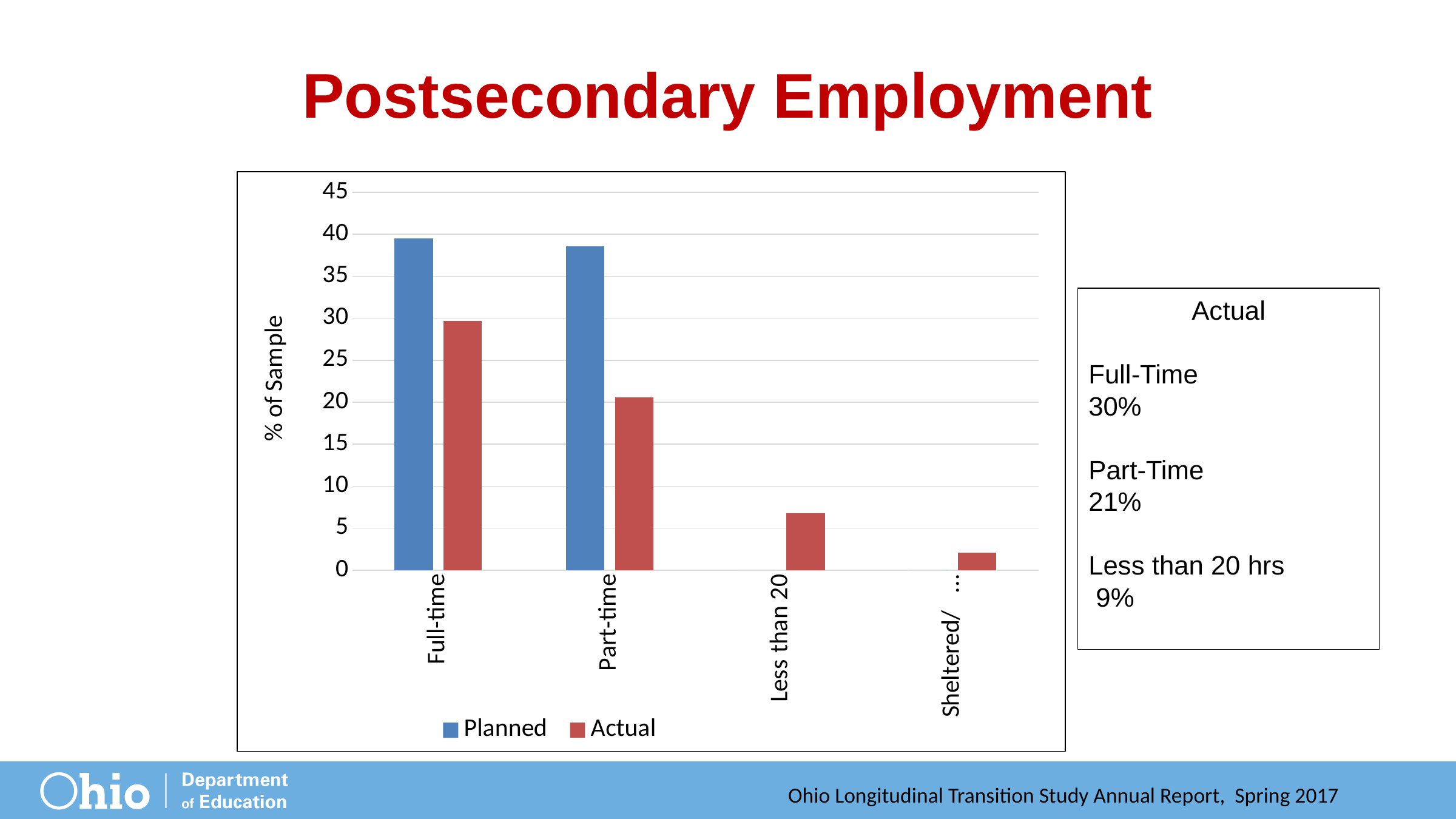
What is the label on the vertical axis of the chart? % of Sample For Full-time, which is larger: the Planned value or the Actual value? Planned Is the Actual value for Part-time greater or less than 25? less Which category has the lowest Actual value? Sheltered/ Do the Actual values rise or fall moving left to right along the x axis? fall Which category has the highest Actual value? Full-time How many series does the chart legend list? 2 What kind of chart is shown on the slide? bar chart How many categories are shown on the x axis of the chart? 4 Which is larger: the Actual value for Full-time or the Actual value for Part-time? Full-time Is the Actual value for Less than 20 greater or less than 10? less Is the Planned value for Full-time greater or less than 35? greater